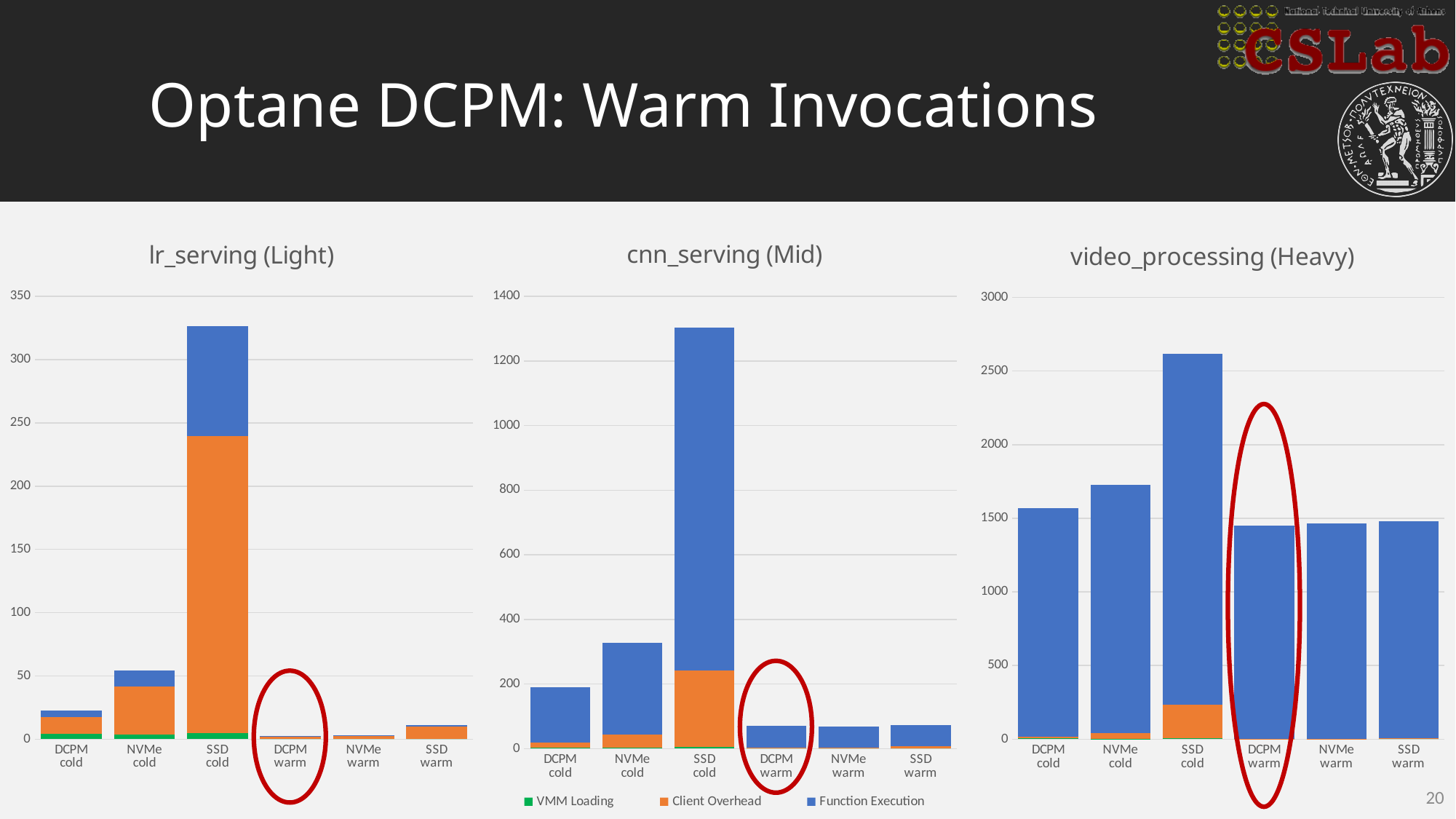
What kind of chart is the lr_serving (Light) chart? stacked bar chart In the video_processing (Heavy) chart, which category has the tallest bar? SSD cold In the cnn_serving (Mid) chart, is the total for SSD cold greater or less than 1200? greater In the lr_serving (Light) chart, is the total for DCPM cold greater or less than 50? less How many categories are shown on the x axis of the cnn_serving (Mid) chart? 6 In the video_processing (Heavy) chart, is the total for NVMe cold greater or less than 2000? less Which series does the orange colour represent in the legend? Client Overhead In the cnn_serving (Mid) chart, which category has the tallest bar? SSD cold How many series does the legend list? 3 In the lr_serving (Light) chart, which category has the tallest bar? SSD cold In the cnn_serving (Mid) chart, which is larger, the total for NVMe cold or DCPM cold? NVMe cold